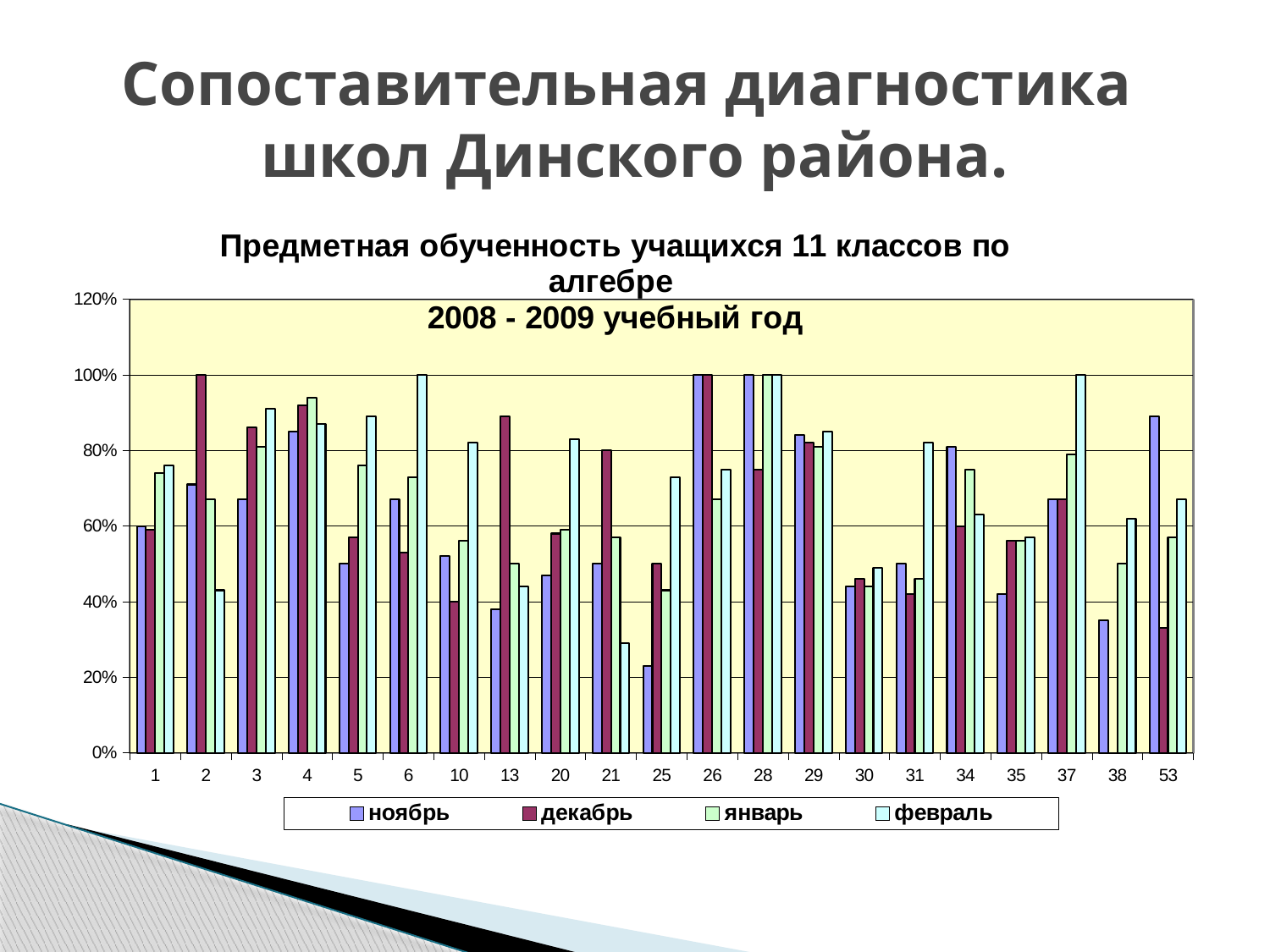
What is the value for декабрь for school 2? 100% For school 2, which is larger: the декабрь value or the февраль value? декабрь What is the value for февраль for school 28? 100% Is the value for ноябрь for school 25 greater or less than 40%? less Is the value for февраль for school 21 greater or less than 40%? less How many series does the legend list? 4 Which series are listed in the legend? ноябрь, декабрь, январь, февраль What kind of chart is shown on the slide? bar chart Is the value for декабрь for school 13 greater or less than 80%? greater What is the value for ноябрь for school 26? 100% How many school categories are shown along the x axis? 21 Which school has the lowest ноябрь value? 25